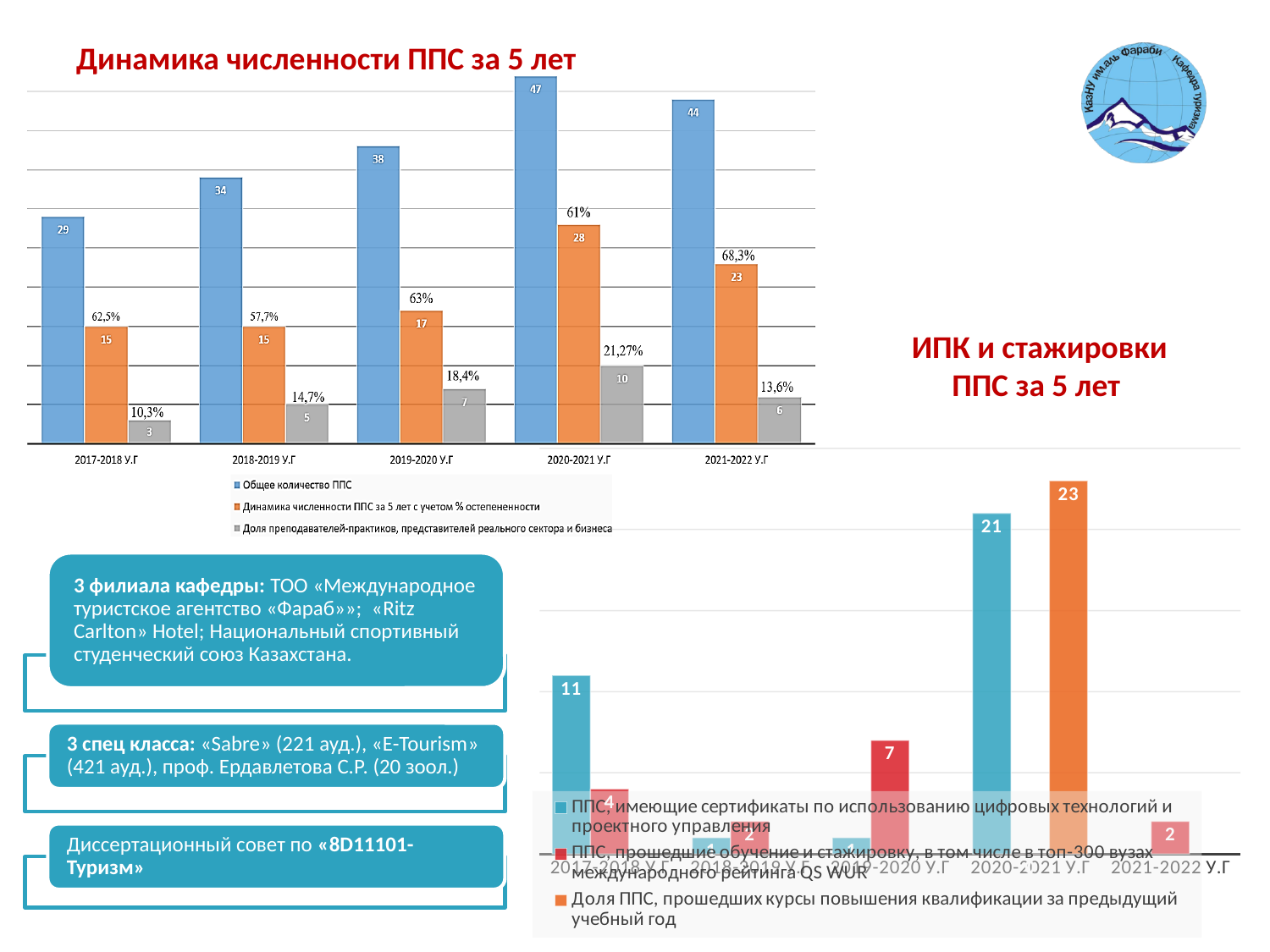
In the chart 'Динамика численности ППС за 5 лет', what percentage is shown above the gray bar for 2020-2021 У.Г? 21,27% What type of chart is 'ИПК и стажировки ППС за 5 лет'? Bar chart In the chart 'Динамика численности ППС за 5 лет', what is the difference between 'Общее количество ППС' in 2020-2021 У.Г and 2021-2022 У.Г? 3 In the chart 'Динамика численности ППС за 5 лет', how many series does the legend list? 3 In the chart 'Динамика численности ППС за 5 лет', which academic year has the highest value of 'Общее количество ППС'? 2020-2021 У.Г In the chart 'Динамика численности ППС за 5 лет', which academic year has the lowest value for the gray series (Доля преподавателей-практиков)? 2017-2018 У.Г In the chart 'Динамика численности ППС за 5 лет', what is the value of 'Общее количество ППС' for 2020-2021 У.Г? 47 In the chart 'Динамика численности ППС за 5 лет', what percentage is shown above the orange bar for 2021-2022 У.Г? 68,3% In the chart 'Динамика численности ППС за 5 лет', how many academic years are shown on the x axis? 5 In the chart 'Динамика численности ППС за 5 лет', what is the value of 'Общее количество ППС' for 2017-2018 У.Г? 29 In the chart 'ИПК и стажировки ППС за 5 лет', which academic year has the highest value for the teal series (ППС, имеющие сертификаты по использованию цифровых технологий и проектного управления)? 2020-2021 У.Г